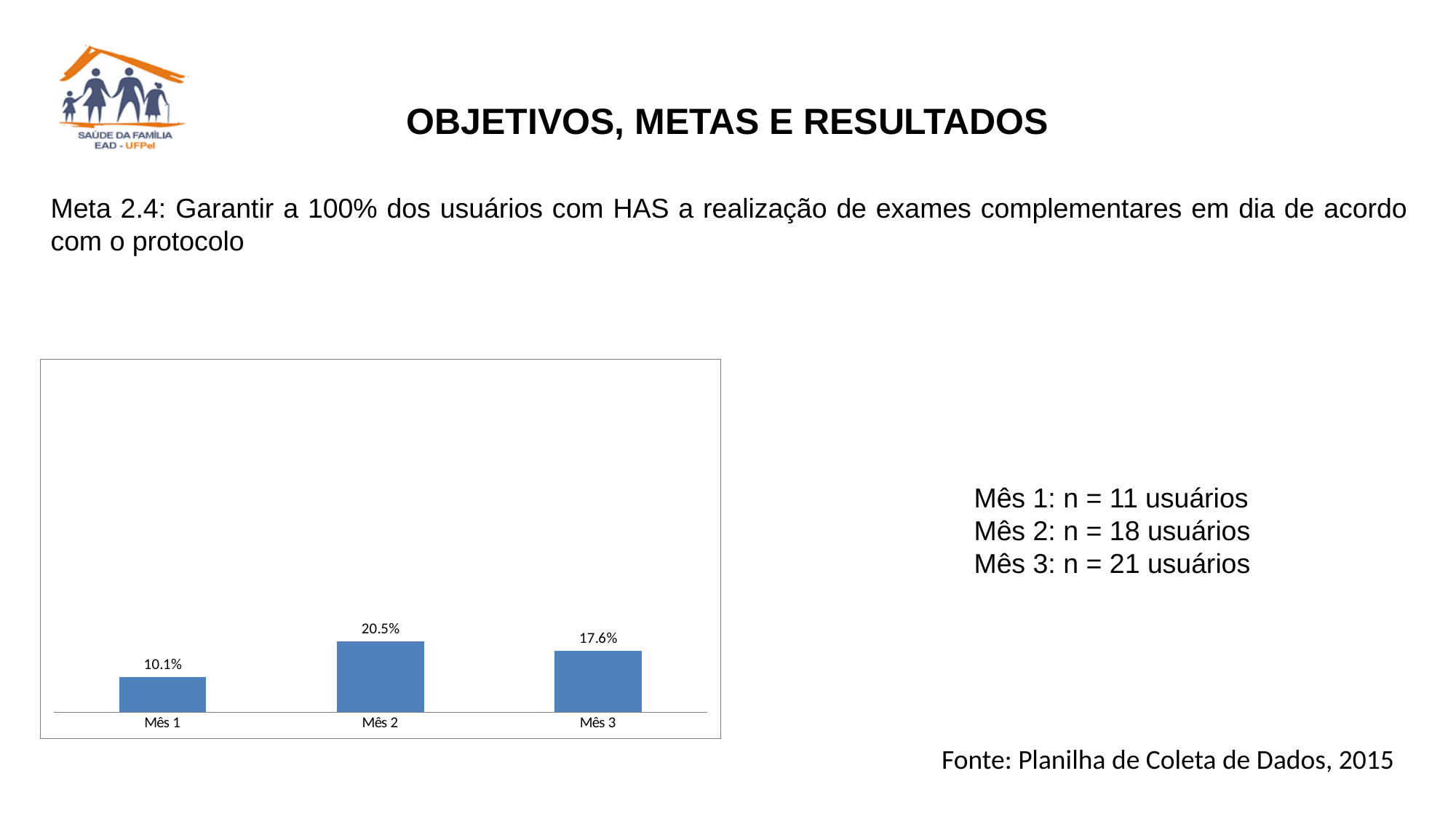
Which month has the lowest value? Mês 1 Which month has the highest value? Mês 2 What is the difference between the values for Mês 2 and Mês 1? 10.4% What is the value for Mês 3? 17.6% What colour are the bars in the chart? Blue What is the difference between the values for Mês 2 and Mês 3? 2.9% How many categories are shown on the x axis of the chart? 3 What is the value for Mês 1? 10.1% What is the value for Mês 2? 20.5% Which is larger, the value for Mês 3 or the value for Mês 1? Mês 3 What kind of chart is shown on the slide? Bar chart Does the value rise or fall from Mês 2 to Mês 3? Fall